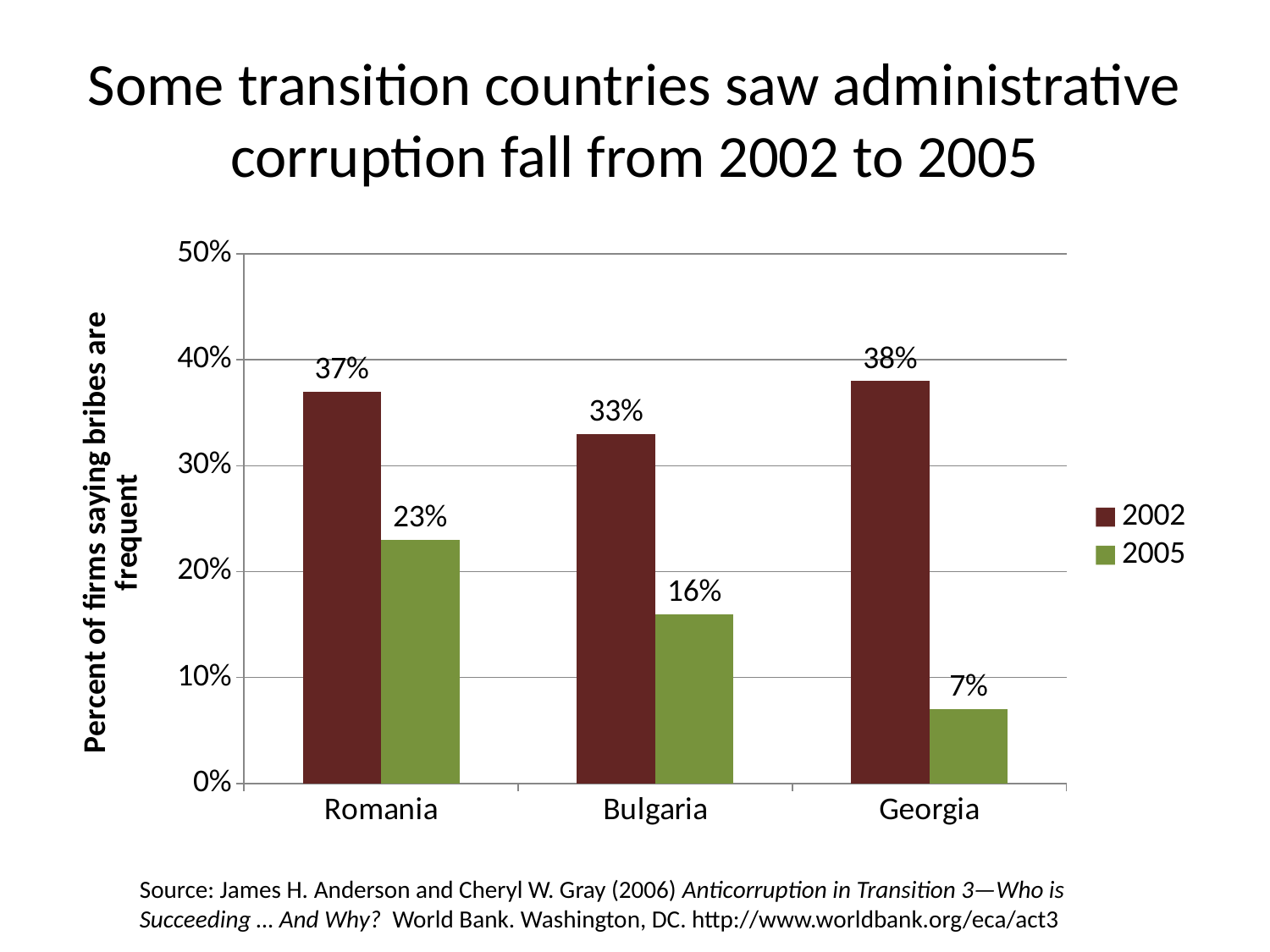
What is the 2005 value for Georgia? 7% What is the difference between Romania's 2002 and 2005 values? 14 percentage points How many countries are shown on the x axis? 3 What is the 2005 value for Bulgaria? 16% Which country has the highest 2002 value? Georgia By how many percentage points did Georgia's value fall from 2002 to 2005? 31 percentage points What kind of chart is shown on the slide? Bar chart How many series does the legend list? 2 What percent of firms in Romania said bribes are frequent in 2002? 37% Which is larger, Romania's 2005 value or Bulgaria's 2005 value? Romania's 2005 value What is the label of the vertical axis? Percent of firms saying bribes are frequent Which country has the lowest 2005 value? Georgia